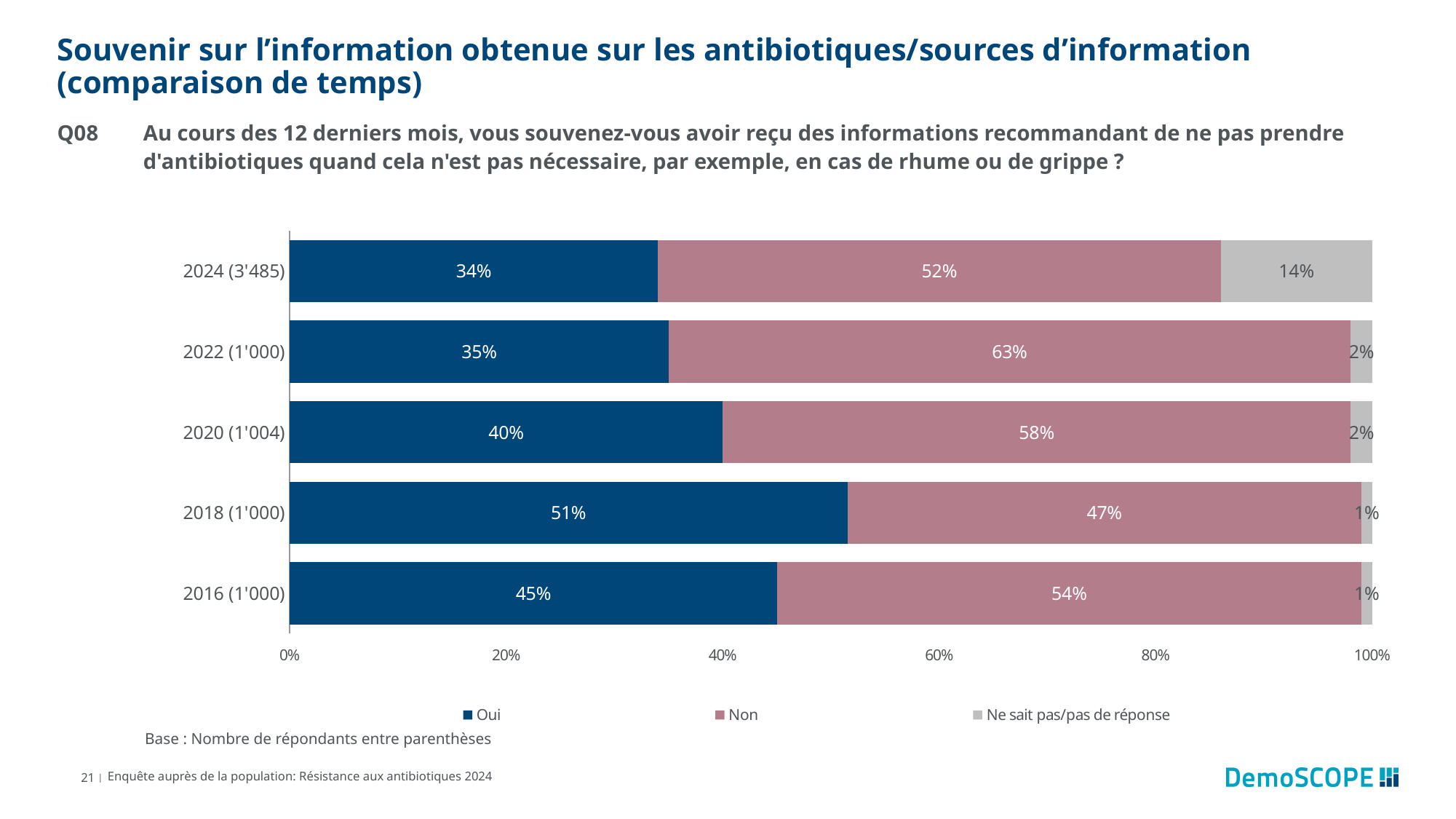
What kind of chart is shown on the slide? Stacked bar chart Which year has the lowest 'Oui' value? 2024 (3'485) What is the 'Ne sait pas/pas de réponse' value for 2024 (3'485)? 14% How many series does the legend list? 3 Which year has the highest 'Oui' value? 2018 (1'000) What is the 'Oui' value for 2024 (3'485)? 34% How many years are shown on the chart? 5 Which is larger: the 'Oui' value for 2020 (1'004) or the 'Oui' value for 2016 (1'000)? 2016 (1'000) Is the 'Non' value for 2024 (3'485) greater or less than 40%? greater What is the total of the 'Oui' and 'Non' segments for 2018 (1'000)? 98% What is the 'Non' value for 2022 (1'000)? 63% What is the difference between the 'Non' values for 2022 (1'000) and 2018 (1'000)? 16%